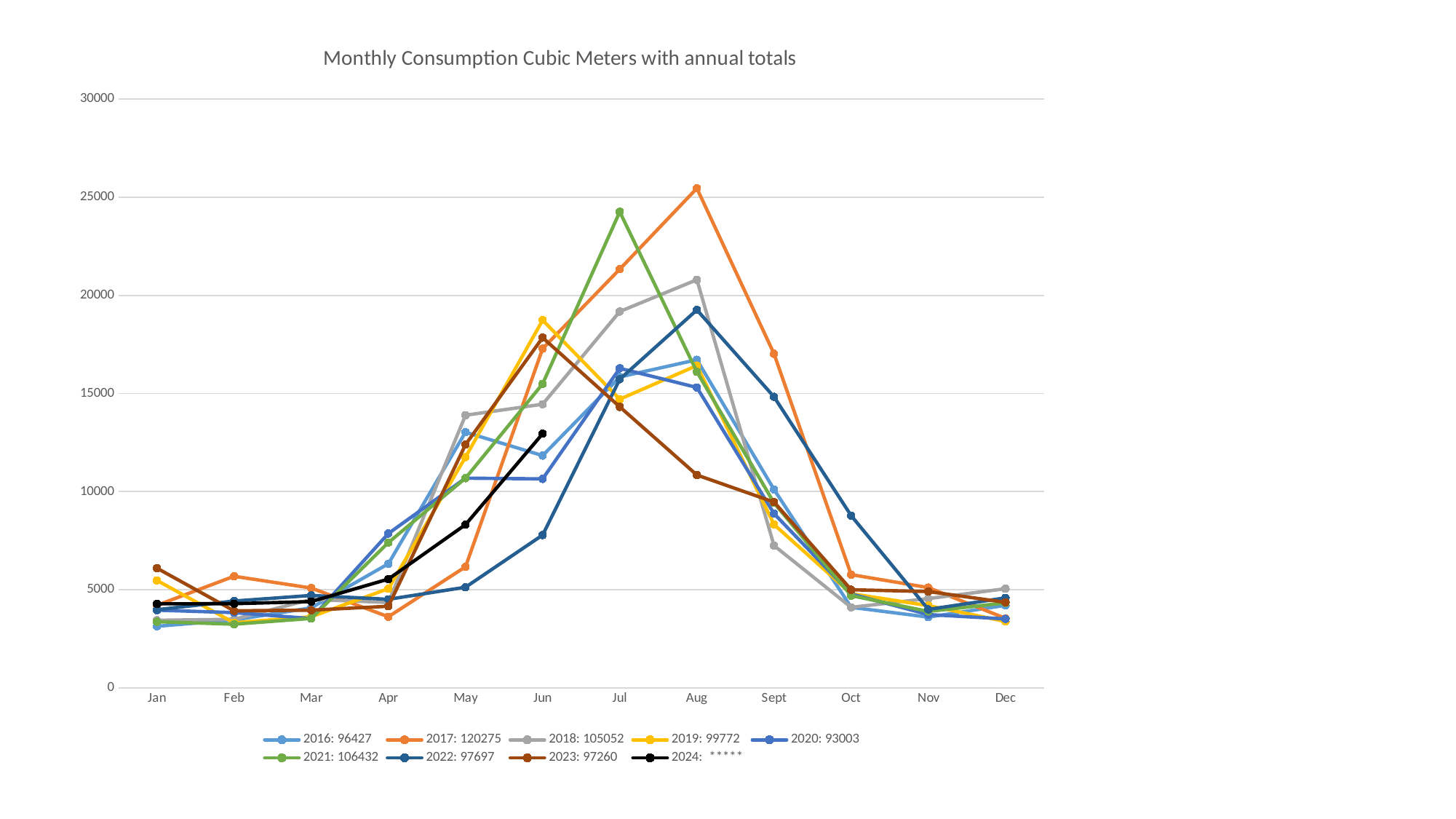
Which is larger, the 2022 value in Aug or the 2023 value in Aug? 2022 Is the value for 2017 in Aug greater or less than 25000? greater What annual total does the legend show for 2017? 120275 How many series does the legend list? 9 What is the difference between the annual totals shown in the legend for 2017 and 2016? 23848 Which year has the lowest annual total shown in the legend? 2020 How many months are shown along the x axis? 12 In which month does the 2017 series reach its highest value? Aug What kind of chart is shown on the slide? line chart Is the value for 2022 in Aug greater or less than 20000? less What is the title of the chart? Monthly Consumption Cubic Meters with annual totals Which year has the highest annual total shown in the legend? 2017